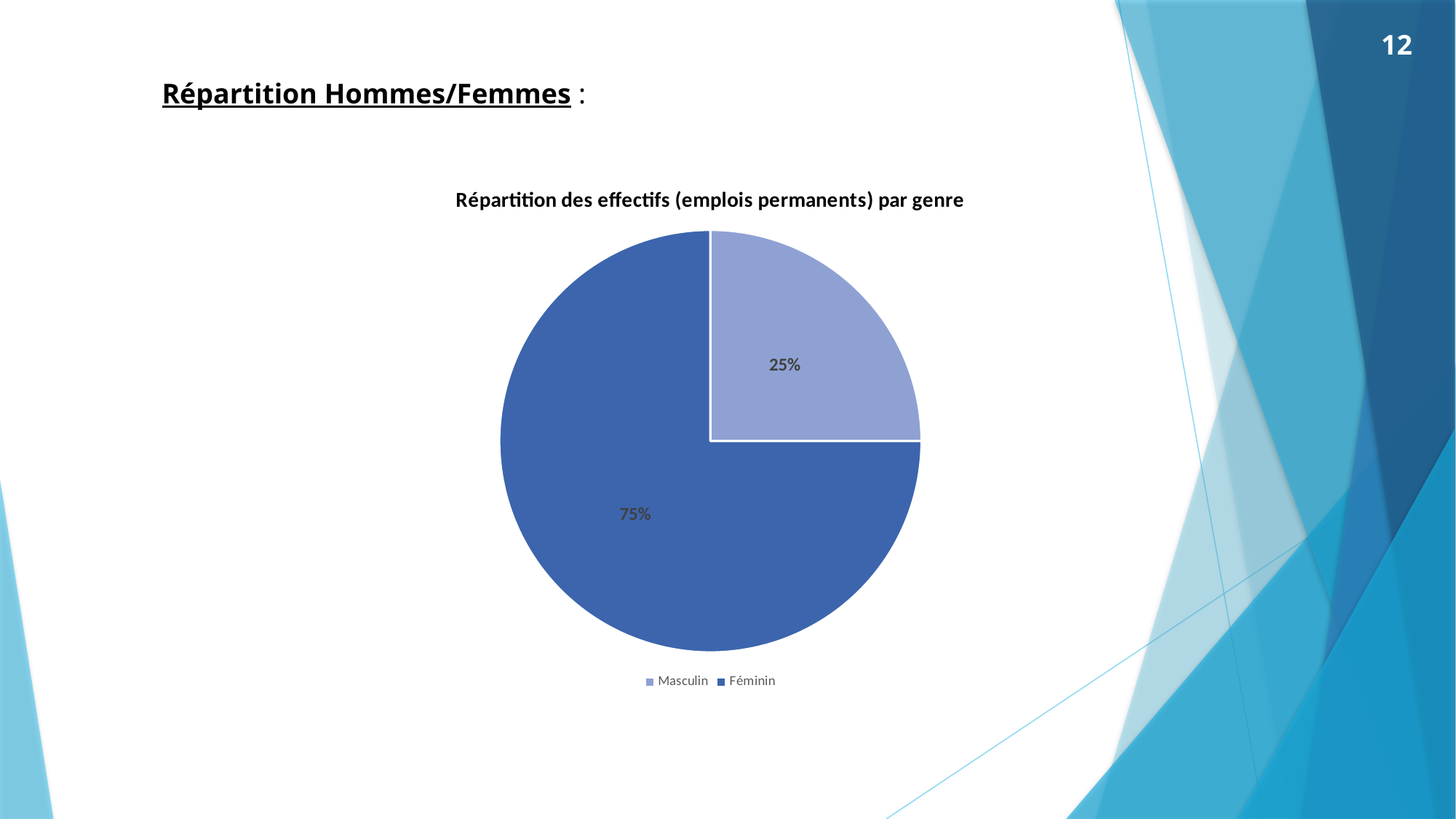
What share of the pie does Féminin represent? 75% How many entries does the legend list? 2 How many categories does the pie chart have? 2 What is the title of the chart? Répartition des effectifs (emplois permanents) par genre Which category has the smallest slice of the pie? Masculin Which category has the largest slice of the pie? Féminin Which category is shown in the lighter blue colour? Masculin What is the difference in percentage points between the Féminin and Masculin slices? 50 percentage points Which is larger, the Masculin slice or the Féminin slice? Féminin What kind of chart is shown on the slide? Pie chart What share of the pie does Masculin represent? 25%